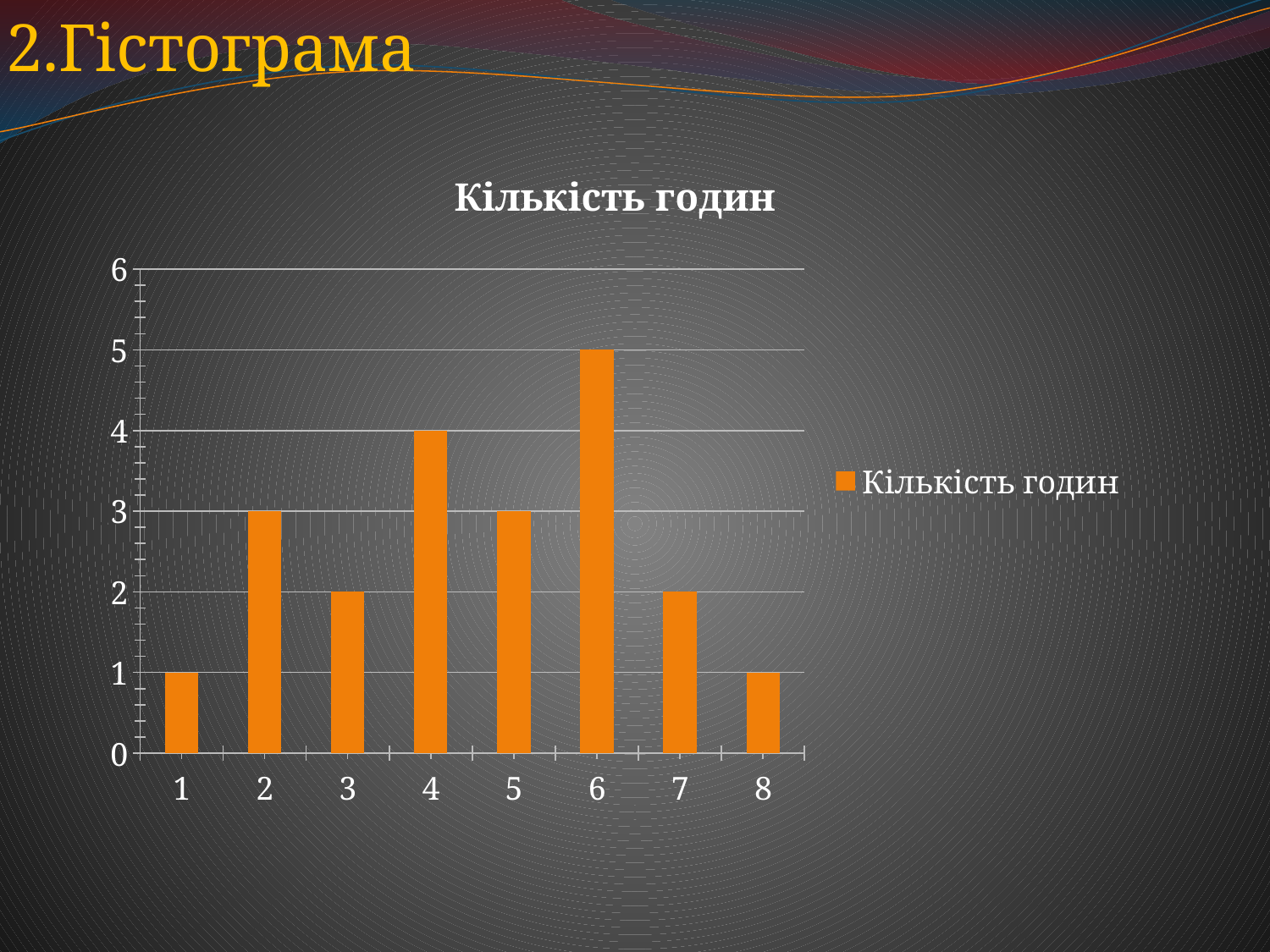
What is the title of the chart? Кількість годин What type of chart is shown on the slide? bar chart Which category has the highest value? 6 How many series does the legend list? 1 How many categories are shown on the x axis? 8 What is the value for category 6? 5 What is the difference between the values for category 6 and category 3? 3 Is the value for category 6 greater or less than 4? greater What is the value for category 4? 4 What is the difference between the values for category 4 and category 1? 3 Which is larger, the value for category 4 or the value for category 7? category 4 What is the value for category 2? 3